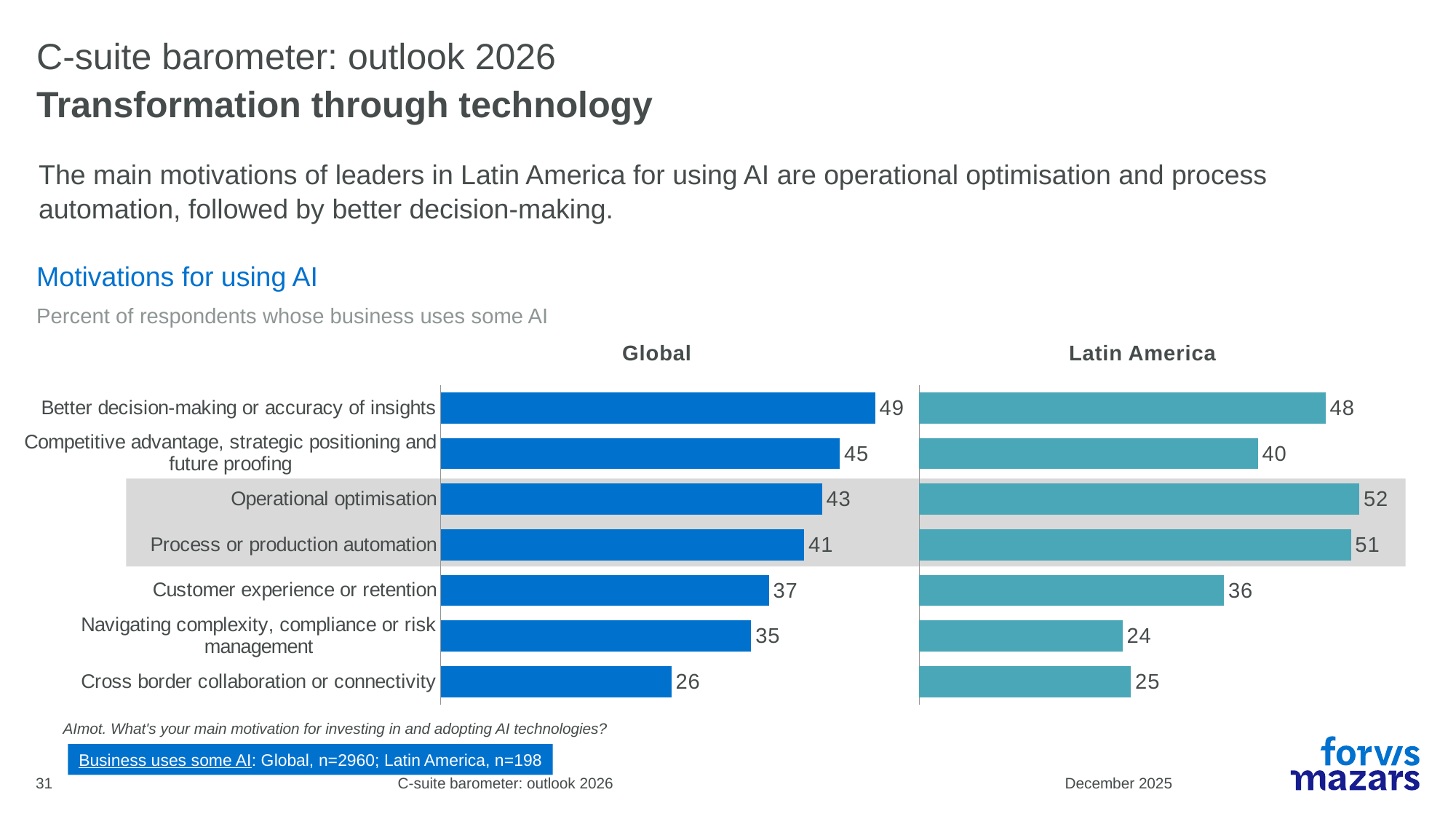
What kind of chart is used to show the Motivations for using AI? Bar chart In the Latin America chart, what is the value for Navigating complexity, compliance or risk management? 24 What is the difference between the Latin America and Global values for Process or production automation? 10 In the Global chart, which category has the lowest value? Cross border collaboration or connectivity In the Global chart, which category has the highest value? Better decision-making or accuracy of insights What is the subtitle shown under the chart title 'Motivations for using AI'? Percent of respondents whose business uses some AI In the Global chart, what is the value for Operational optimisation? 43 In the Latin America chart, what is the value for Process or production automation? 51 How many categories are shown in the Global chart? 7 For Competitive advantage, strategic positioning and future proofing, which is larger: the Global value or the Latin America value? Global In the Latin America chart, which category has the highest value? Operational optimisation In the Latin America chart, which category has the lowest value? Navigating complexity, compliance or risk management